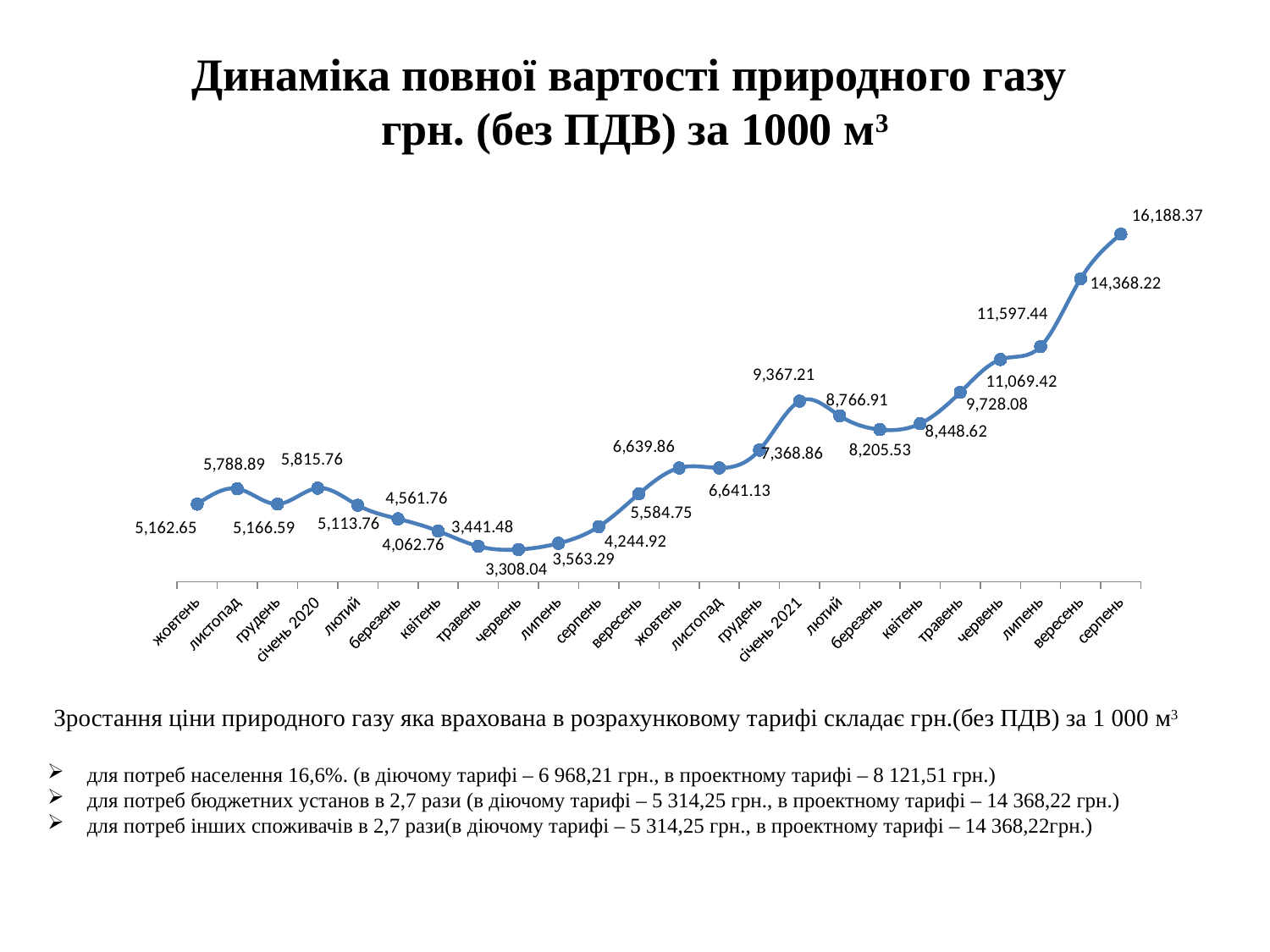
What is the value for січень 2020? 5,815.76 What is the value for the last point on the chart (серпень)? 16,188.37 Which is larger, the value for січень 2020 or the value for січень 2021? січень 2021 What kind of chart is shown on the slide? line chart What is the value for січень 2021? 9,367.21 What is the value for the first point on the chart (жовтень, before січень 2020)? 5,162.65 How many data points are plotted on the chart? 24 Which point has the lowest value on the chart? червень 2020, 3,308.04 What is the title of the chart? Динаміка повної вартості природного газу грн. (без ПДВ) за 1000 м³ What is the difference between the values for січень 2021 and січень 2020? 3,551.45 Do the values rise or fall from січень 2020 to червень 2020? fall Which point has the highest value on the chart? серпень (the last point), 16,188.37